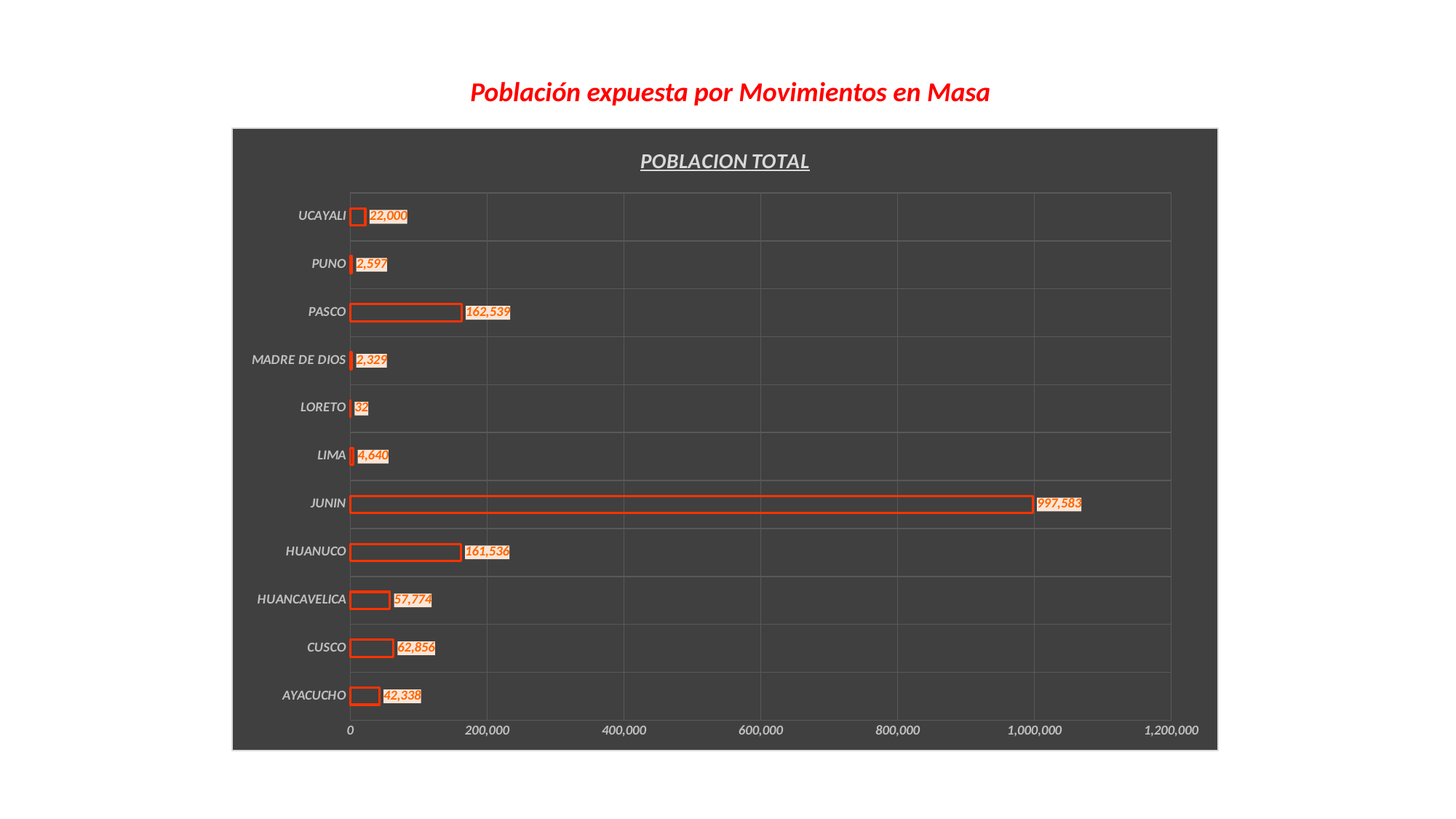
Which category has the highest value? JUNIN What is the value for AYACUCHO? 42,338 What is the value for PASCO? 162,539 How many categories are shown in the chart? 11 Which category has the lowest value? LORETO What is the value for JUNIN? 997,583 Which is larger, the value for PASCO or the value for HUANUCO? PASCO Is the value for JUNIN greater or less than 800,000? greater What is the difference between the values for CUSCO and HUANCAVELICA? 5,082 What is the title of the chart? POBLACION TOTAL What is the value for LORETO? 32 What kind of chart is shown? bar chart